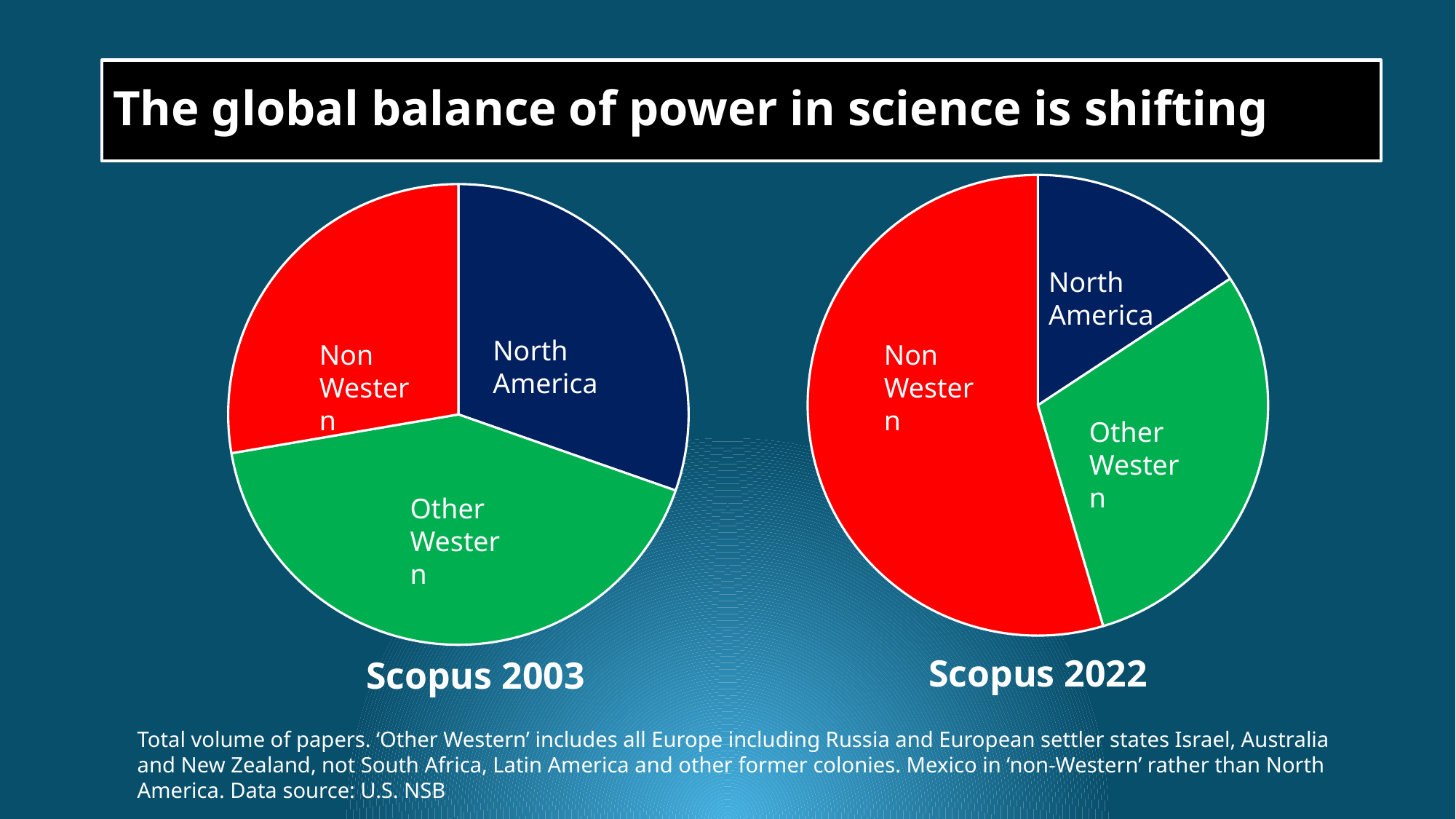
What kind of chart is the Scopus 2022 chart? Pie chart In the Scopus 2003 pie chart, which category has the largest slice? Other Western In the Scopus 2022 pie chart, which slice is larger: North America or Other Western? Other Western How many slices does the Scopus 2003 pie chart have? 3 In the Scopus 2022 pie chart, which slice is larger: Non Western or Other Western? Non Western What kind of chart is the Scopus 2003 chart? Pie chart In the Scopus 2022 pie chart, which category has the smallest slice? North America In the Scopus 2022 pie chart, which category has the largest slice? Non Western How many slices does the Scopus 2022 pie chart have? 3 What colour is the Non Western slice in both pie charts? Red What is the title of the slide containing the two pie charts? The global balance of power in science is shifting Comparing the two pie charts, is the Non Western slice larger in Scopus 2003 or Scopus 2022? Scopus 2022